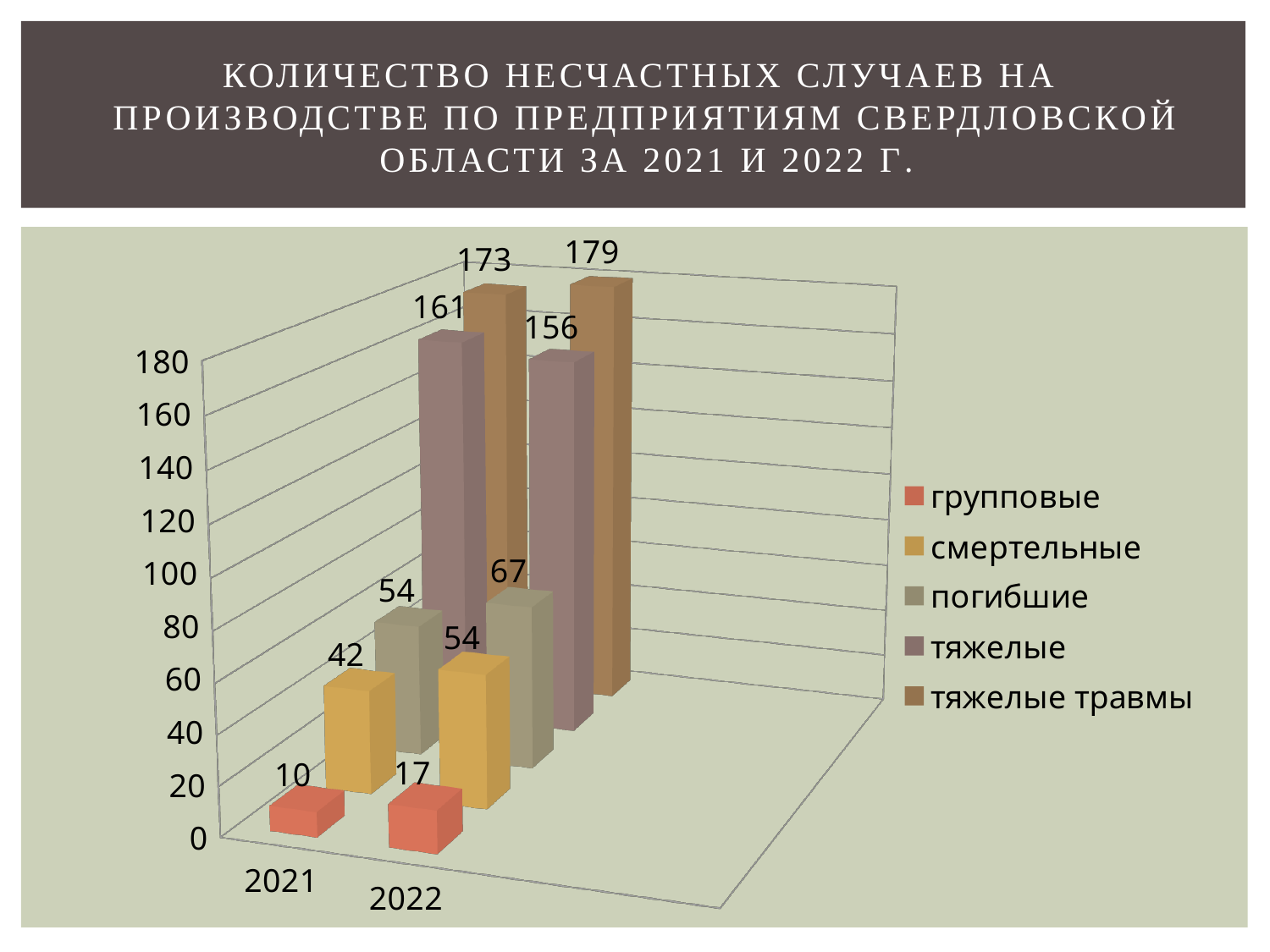
What is the difference between the погибшие values for 2022 and 2021? 13 What is the value for тяжелые in 2021? 161 Which is larger, the тяжелые value for 2021 or for 2022? 2021 Which series has the lowest value in 2021? групповые Do the values for групповые rise or fall from 2021 to 2022? rise What is the value for смертельные in 2022? 54 What is the value for групповые in 2021? 10 How many categories are shown on the x axis? 2 How many series does the legend list? 5 Which series has the highest value in 2022? тяжелые травмы What type of chart is shown on the slide? bar chart What is the value for тяжелые травмы in 2022? 179